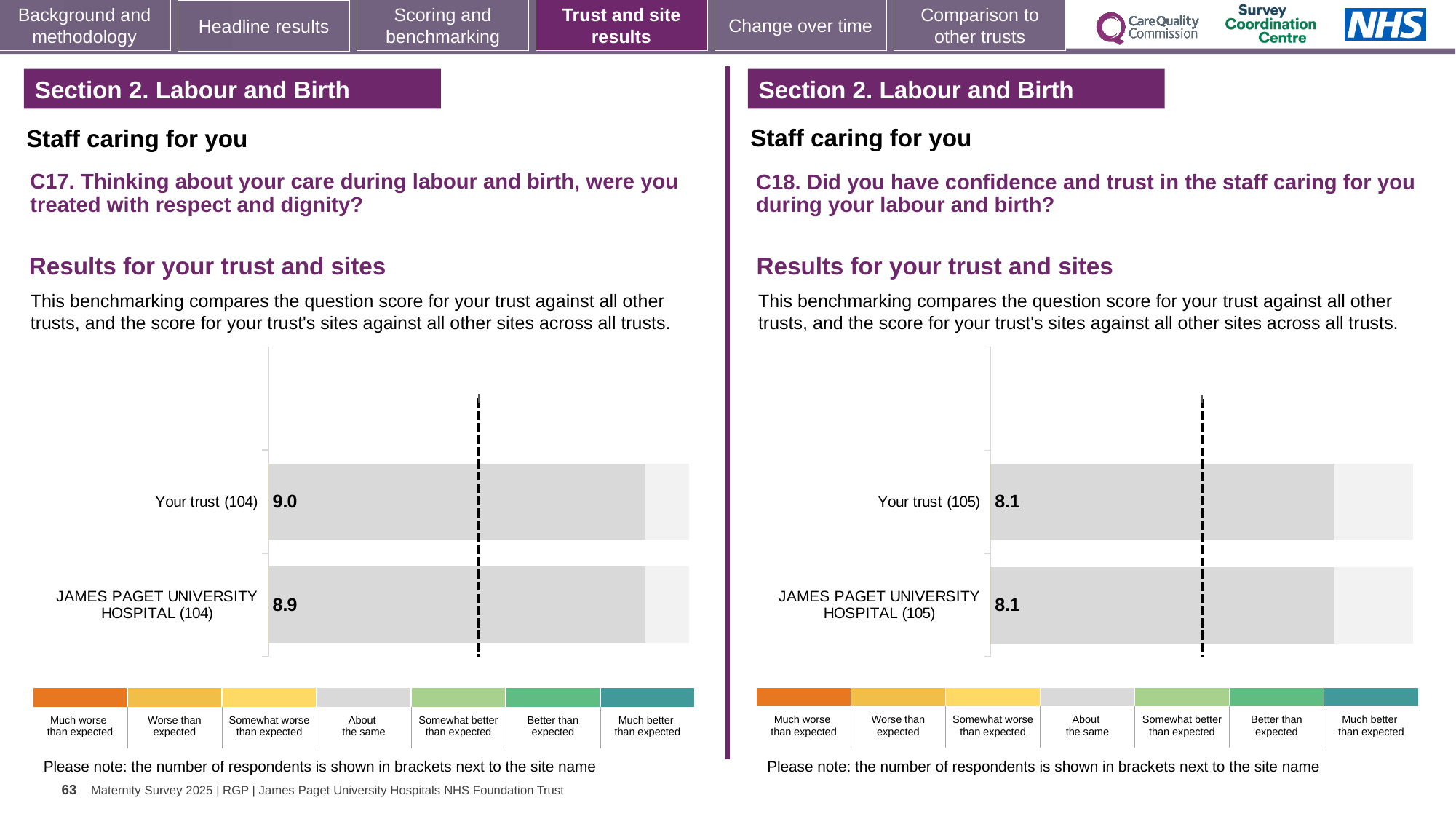
How many bars are plotted on the C18 chart (right)? 2 On the C18 chart (right), what is the score for Your trust? 8.1 On the C18 chart (right), what is the score for James Paget University Hospital? 8.1 How many bars are plotted on the C17 chart (left)? 2 On the C18 chart (right), how many respondents are shown in brackets next to Your trust? 105 On the C17 chart (left), how many respondents are shown in brackets next to James Paget University Hospital? 104 What type of chart is used on the C17 chart (left)? Bar chart On the C17 chart (left), which has the higher score, Your trust or James Paget University Hospital? Your trust On the C17 chart (left), what is the score for James Paget University Hospital? 8.9 On the C17 chart (left), what is the score for Your trust? 9.0 On the C17 chart (left), what is the difference between the Your trust score and the James Paget University Hospital score? 0.1 On the C18 chart (right), what is the difference between the Your trust score and the James Paget University Hospital score? 0.0